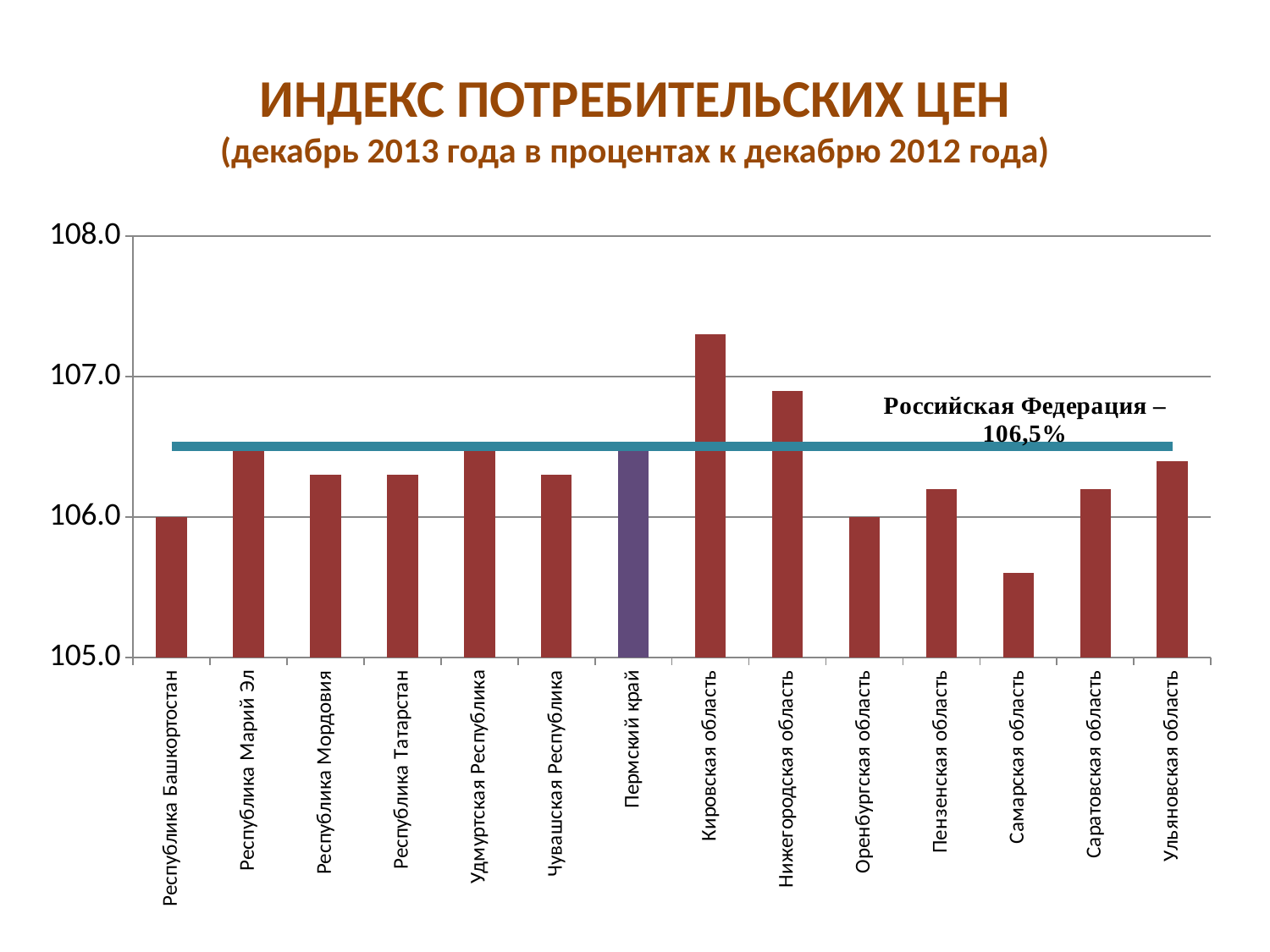
What kind of chart is shown on the slide? bar chart Which is larger, the value for Самарская область or for Саратовская область? Саратовская область Is the value for Самарская область greater or less than 106.0? less Is the value for Нижегородская область greater or less than 107.0? less Which region has the highest consumer price index on the chart? Кировская область Which is larger, the value for Кировская область or for Нижегородская область? Кировская область Which region's bar is shown in a different colour (purple) from the others? Пермский край Is the value for Кировская область greater or less than 107.0? greater How many regions are plotted on the chart? 14 Which region has the lowest consumer price index on the chart? Самарская область What value for the Российская Федерация is marked by the horizontal line on the chart? 106,5%